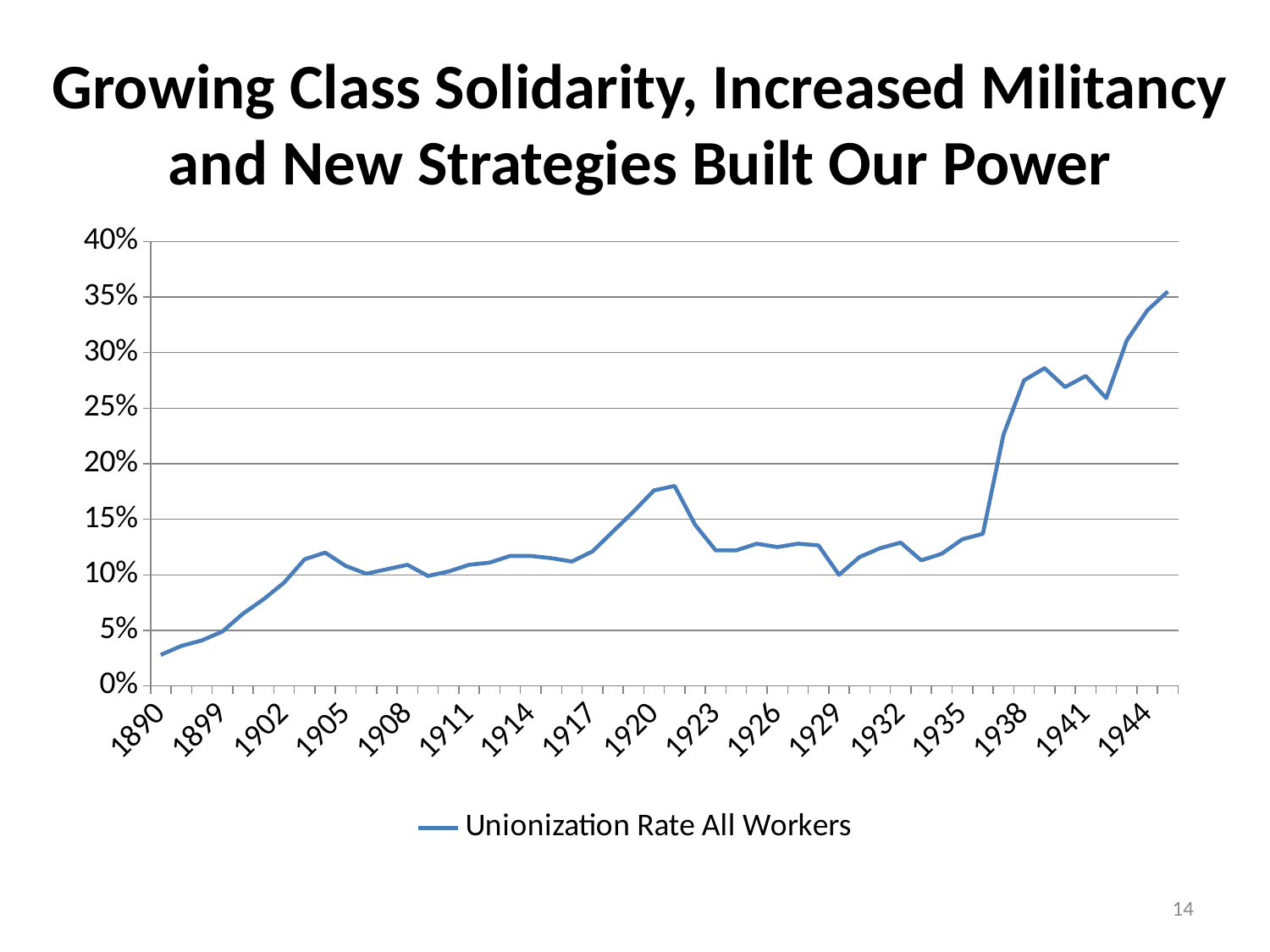
Is the unionization rate for 1938 greater or less than 25%? greater Does the unionization rate rise or fall between 1920 and 1923? fall Which year has the lowest unionization rate on the chart? 1890 What kind of chart is shown on the slide? line chart What is the name of the series shown in the legend? Unionization Rate All Workers Is the unionization rate for 1944 greater or less than 30%? greater Which year has the higher unionization rate, 1920 or 1929? 1920 Is the unionization rate for 1890 greater or less than 5%? less How many series does the legend list? 1 Does the unionization rate rise or fall between 1935 and 1938? rise